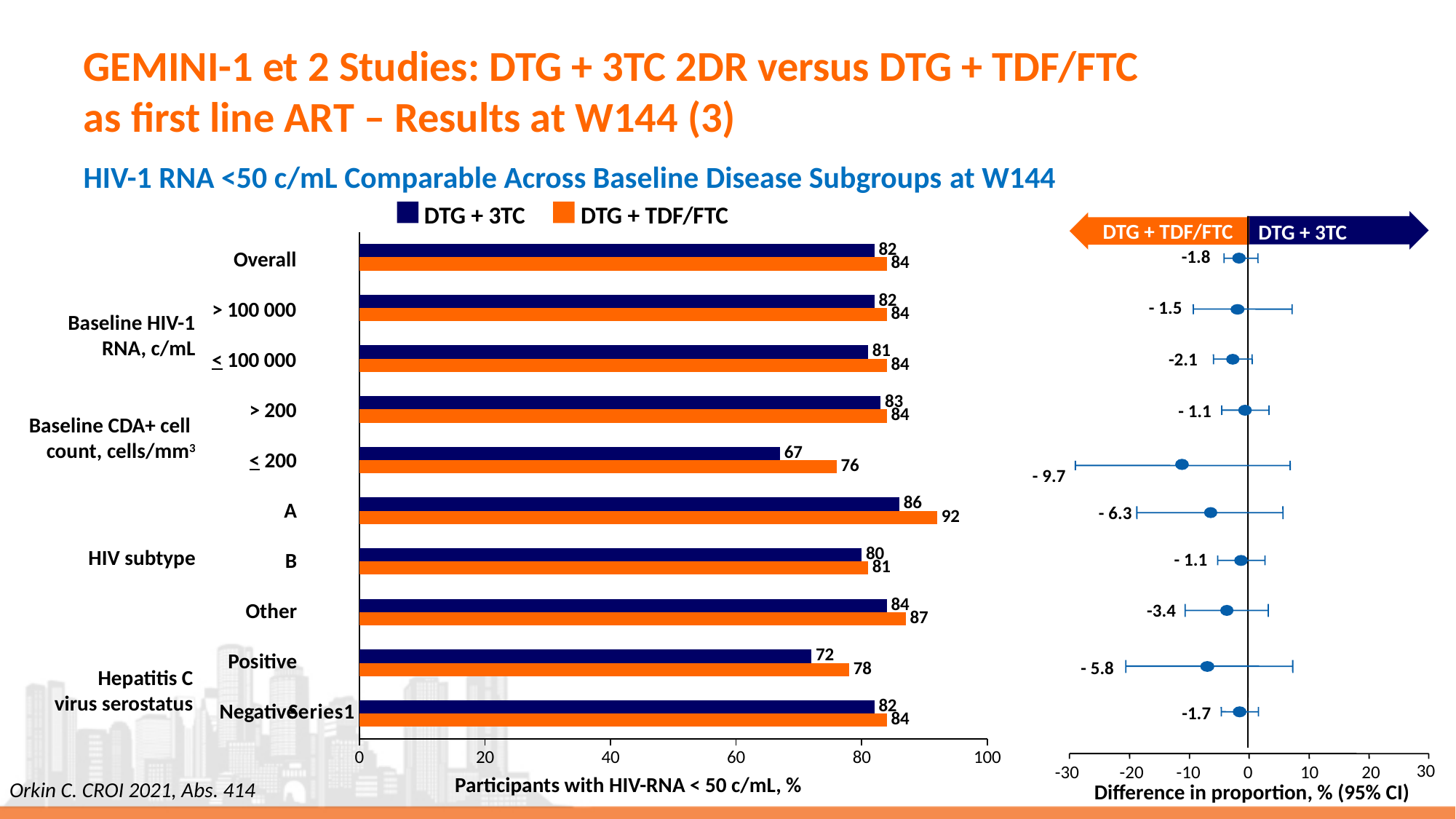
In the bar chart, what is the value for DTG + TDF/FTC in the HIV subtype A category? 92 What is the x-axis label of the bar chart on the left? Participants with HIV-RNA < 50 c/mL, % How many series does the legend of the bar chart list? 2 In the bar chart, what is the value for DTG + 3TC in the Overall category? 82 In the forest plot on the right, what is the difference in proportion for the Overall category? -1.8 In the bar chart, what is the value for DTG + 3TC in the HIV subtype B category? 80 In the forest plot on the right, what is the difference in proportion for the ≤ 200 CD4+ cell count category? - 9.7 In the bar chart, which category has the highest value for DTG + TDF/FTC? A (HIV subtype) In the bar chart, which category has the lowest value for DTG + 3TC? ≤ 200 (Baseline CD4+ cell count) In the bar chart, which is larger for the ≤ 200 CD4+ cell count category: DTG + 3TC or DTG + TDF/FTC? DTG + TDF/FTC What kind of chart is the chart on the left of the slide? Bar chart In the bar chart, what is the difference between DTG + TDF/FTC and DTG + 3TC for the Hepatitis C virus serostatus Positive category? 6